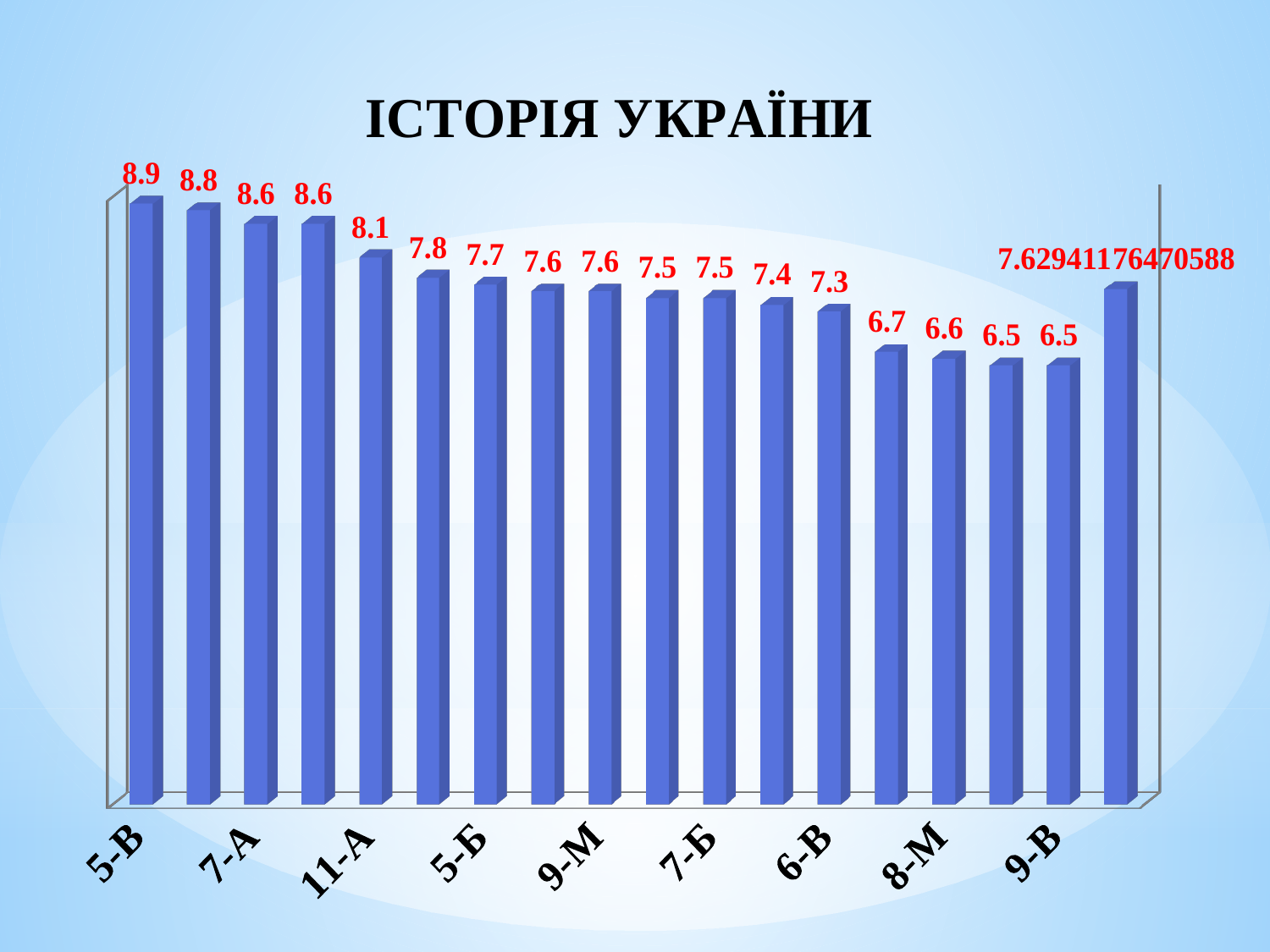
What is the title of the chart? ІСТОРІЯ УКРАЇНИ What is the value for 9-М? 7.6 What is the value for 7-А? 8.6 What type of chart is shown on the slide? bar chart Which has a larger value, 7-А or 11-А? 7-А What is the value for 9-В? 6.5 What is the value for 6-В? 7.3 What is the lowest value shown on the chart? 6.5 What is the value for 11-А? 8.1 What is the difference between the values for 5-В and 9-В? 2.4 Which labeled class has the highest value? 5-В What is the value for 5-В? 8.9